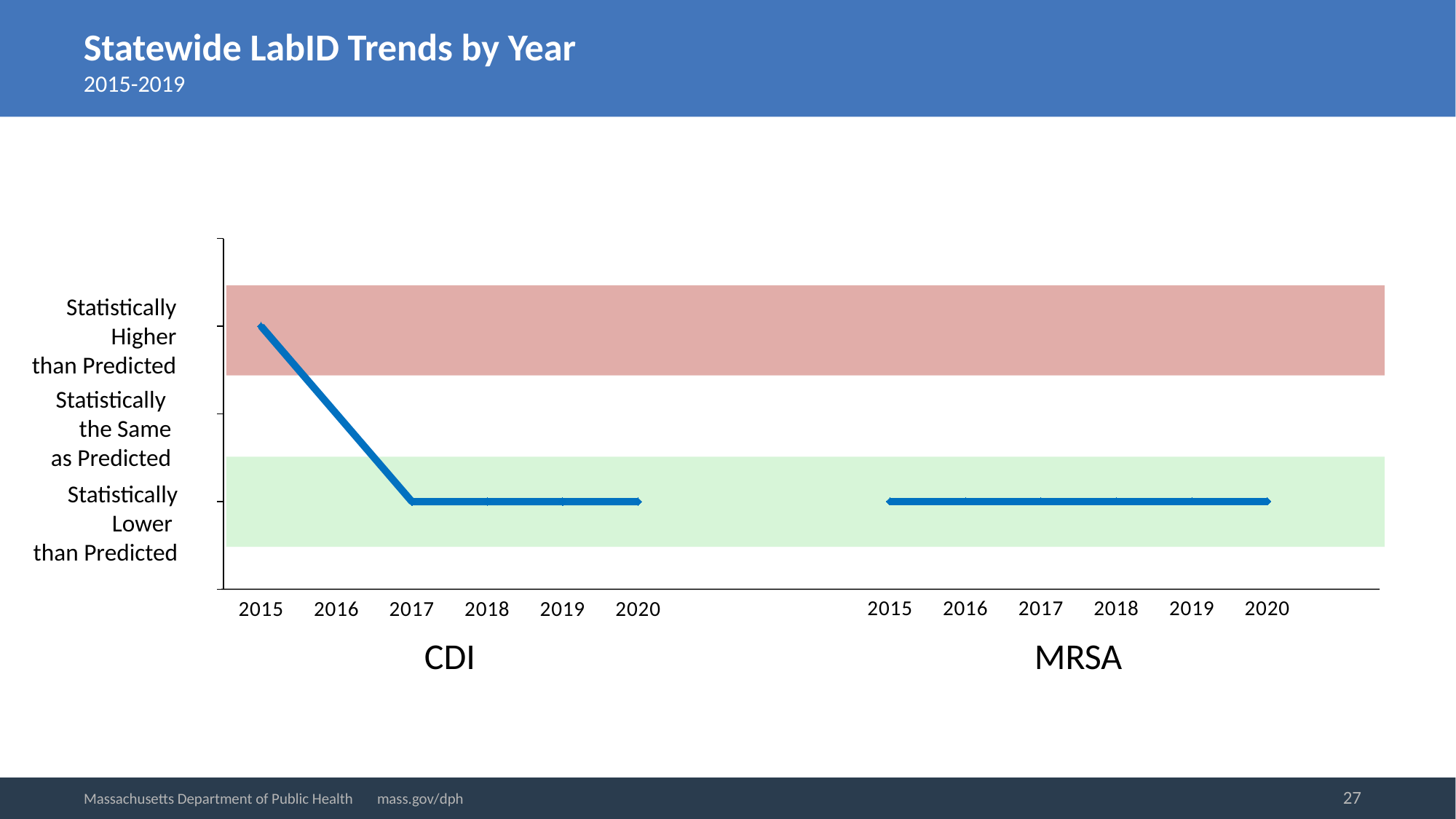
What is the title of the slide containing the chart? Statewide LabID Trends by Year Which is plotted higher, CDI in 2015 or MRSA in 2015? CDI in 2015 How many years are labelled on the x axis for MRSA? 6 Does the CDI line rise or fall from 2015 to 2017? fall For MRSA, what category does the 2019 point fall in? Statistically Lower than Predicted For MRSA, what category does the 2015 point fall in? Statistically Lower than Predicted Does the MRSA line rise, fall, or stay flat from 2015 to 2020? stay flat What kind of chart is shown on the slide? line chart For CDI, what category does the 2015 point fall in? Statistically Higher than Predicted For CDI, what category does the 2020 point fall in? Statistically Lower than Predicted Which CDI year is plotted highest on the chart? 2015 How many years are labelled on the x axis for CDI? 6